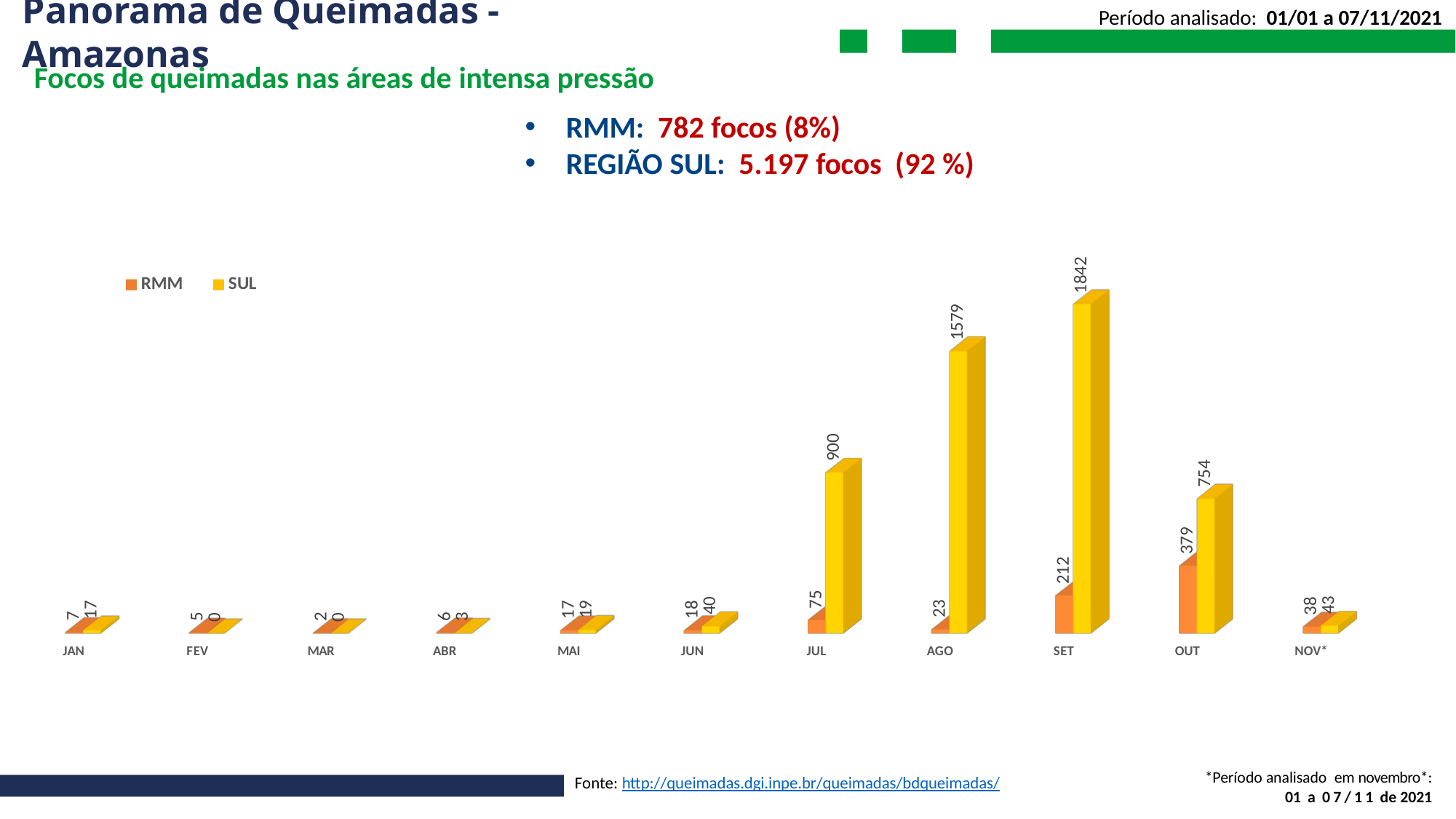
Which month has the highest SUL value? SET How many months are shown on the x axis? 11 How many series does the legend list? 2 Which month has the highest RMM value? OUT Which is larger in OUT, the RMM value or the SUL value? SUL What is the difference between the SUL values for SET and AGO? 263 What kind of chart is shown on the slide? Bar chart What is the SUL value for JUL? 900 Which series is shown in yellow in the legend? SUL What is the SUL value for SET? 1842 What is the RMM value for SET? 212 What is the RMM value for OUT? 379